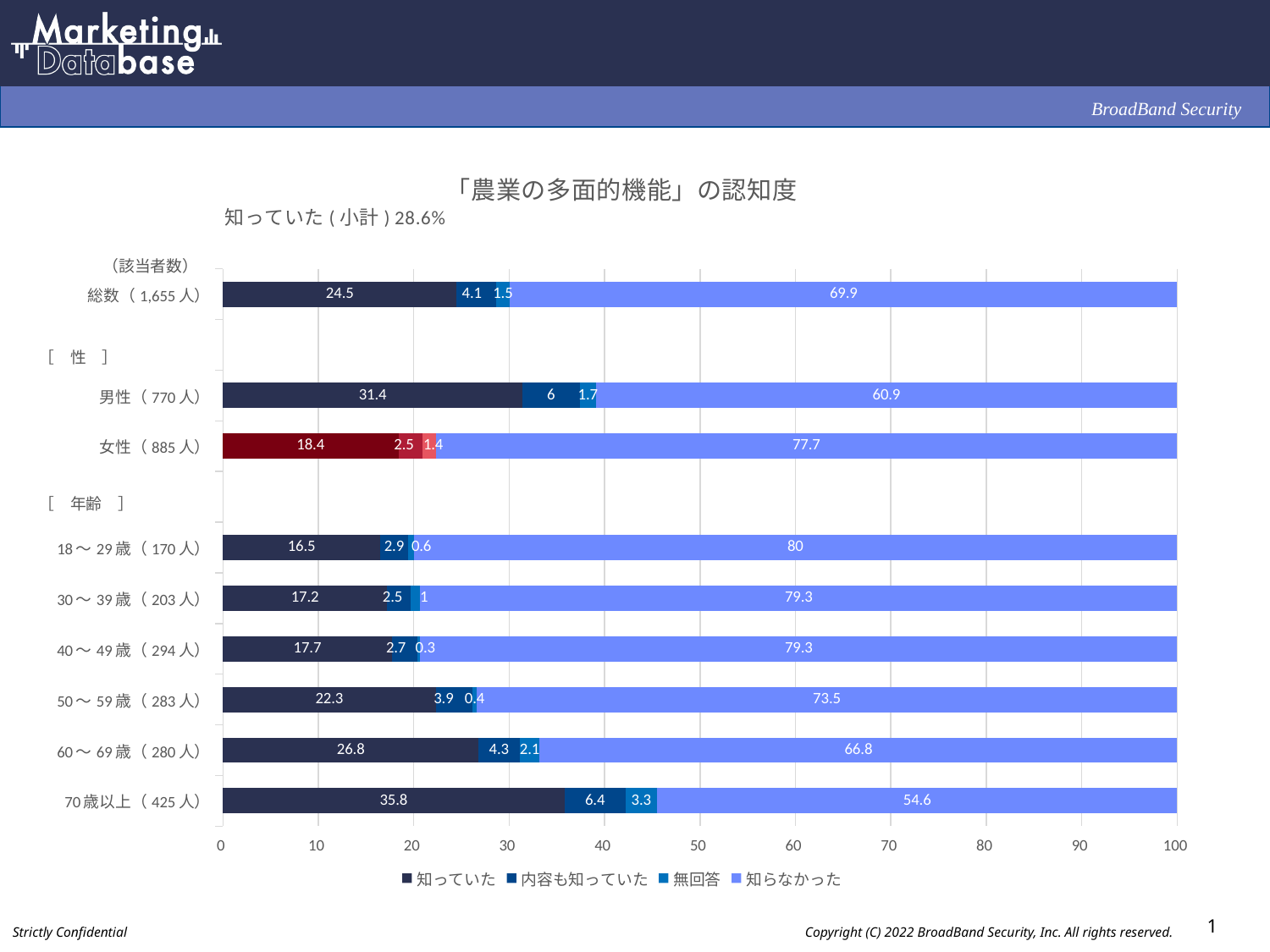
What is the 知っていた value for 男性 (770人)? 31.4 What is the 知らなかった value for 総数 (1,655人)? 69.9 What type of chart is shown on the slide? Stacked bar chart What is the 無回答 value for 70歳以上 (425人)? 3.3 Which category has the highest 知っていた value? 70歳以上 (425人) How many category bars are plotted in the chart? 9 Across the age groups from 18〜29歳 to 70歳以上, does the 知っていた value generally rise or fall? Rise What is the title of the chart? 「農業の多面的機能」の認知度 What is the difference between the 知っていた values for 男性 (770人) and 女性 (885人)? 13 Which category has the lowest 知らなかった value? 70歳以上 (425人) Which is larger, the 内容も知っていた value for 60〜69歳 (280人) or for 50〜59歳 (283人)? 60〜69歳 (280人) How many series does the legend list? 4